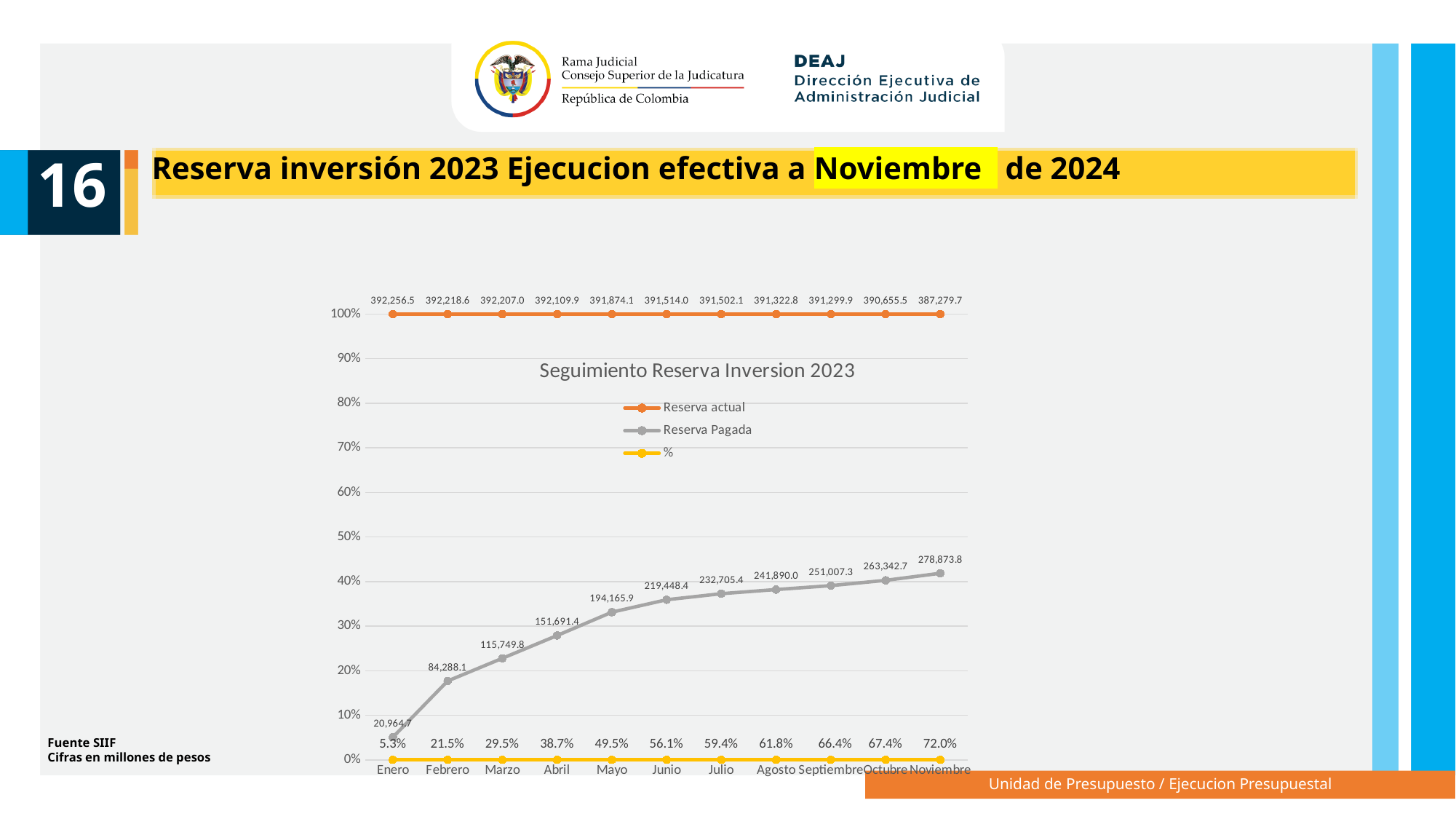
What is the difference between the Reserva Pagada values for Noviembre and Octubre? 15,531.1 What is the Reserva Pagada value for Noviembre? 278,873.8 In which month is the Reserva actual value lowest? Noviembre What is the Reserva Pagada value for Mayo? 194,165.9 Does the % series rise or fall from Enero to Noviembre? Rise How many months are plotted on the x axis? 11 How many series does the legend list? 3 What kind of chart is shown? Line chart What percentage (%) is shown for Junio? 56.1% In which month is the Reserva Pagada value lowest? Enero Which is larger, the Reserva Pagada value for Marzo or for Abril? Abril What is the Reserva actual value for Enero? 392,256.5